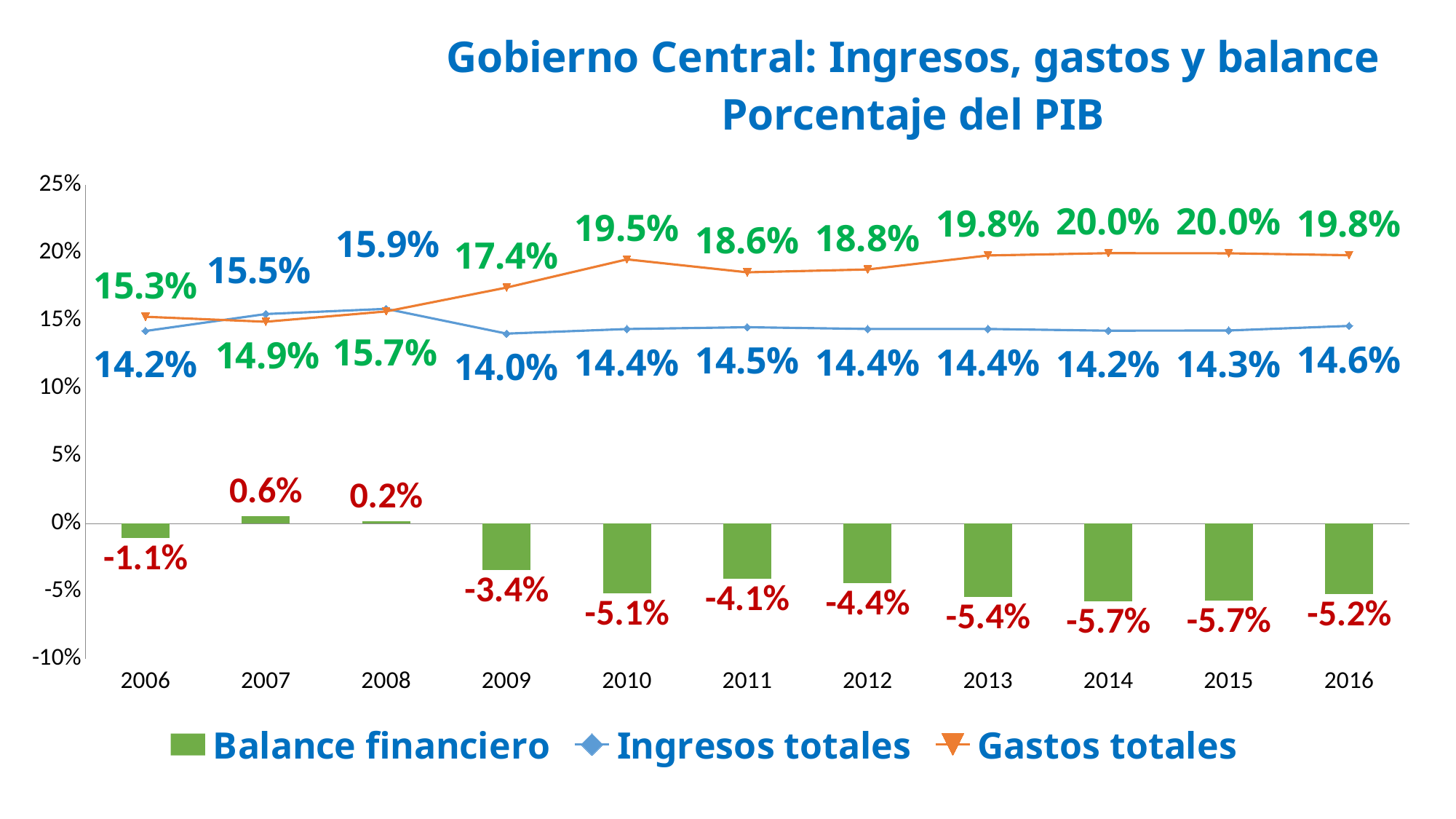
What is the Balance financiero value for 2010? -5.1% What kind of chart is this? Combined bar and line chart In which year is the Balance financiero highest? 2007 Do Gastos totales rise or fall from 2009 to 2014? Rise In which year are Ingresos totales highest? 2008 How many years are shown on the x axis? 11 In 2006, which is larger: Ingresos totales or Gastos totales? Gastos totales What is the Ingresos totales value for 2008? 15.9% What is the Gastos totales value for 2016? 19.8% What is the Balance financiero value for 2007? 0.6% How many series does the legend list? 3 What is the difference between Gastos totales and Ingresos totales in 2014? 5.8%